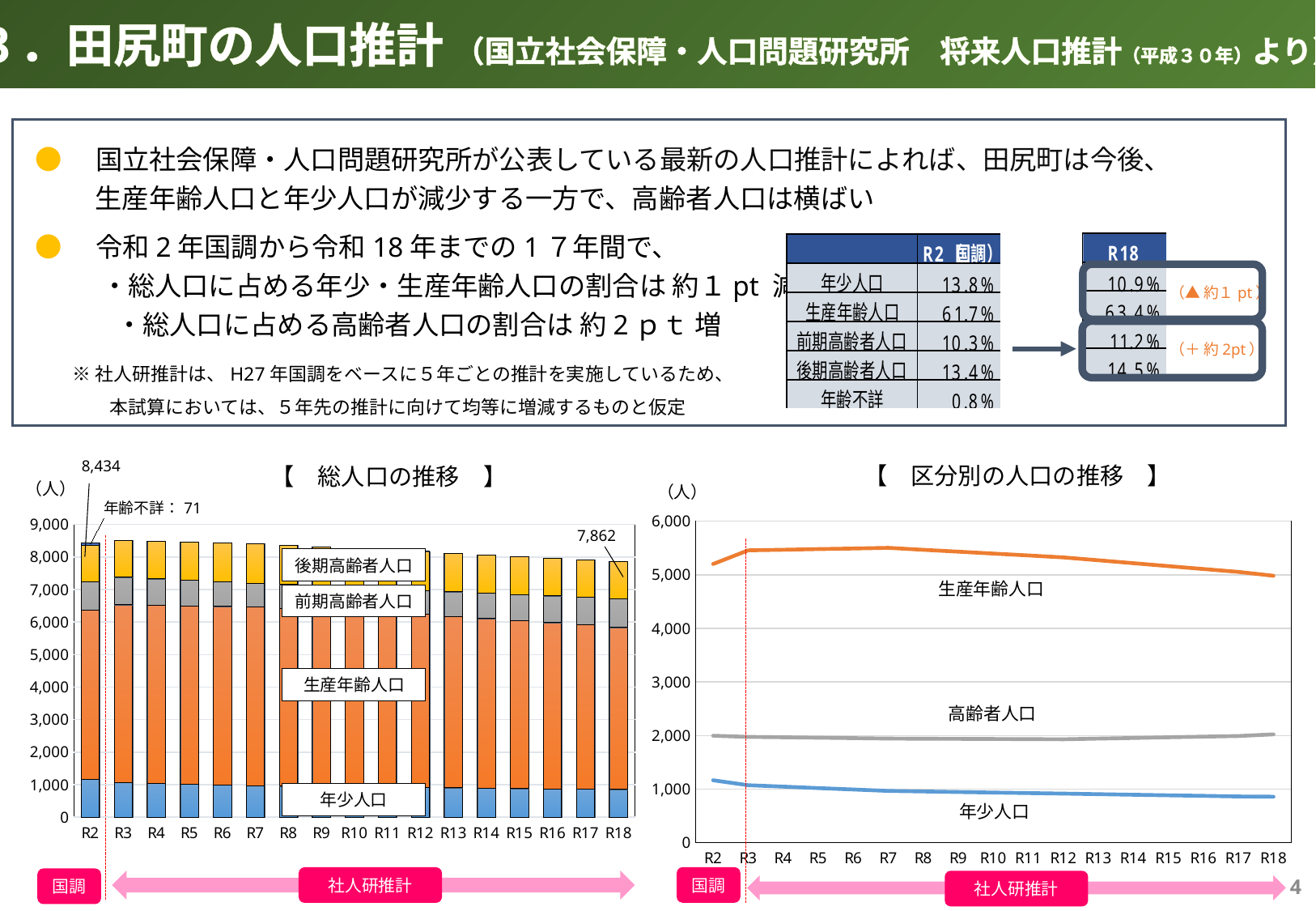
In the 区分別の人口の推移 chart, which population group has the lowest line? 年少人口 In the 区分別の人口の推移 chart, which population group has the highest line? 生産年齢人口 In the 総人口の推移 chart, how many years (bars) are shown on the x axis? 17 In the 総人口の推移 chart, what is the total population value labelled for R2? 8,434 In the 区分別の人口の推移 chart, is the value of 年少人口 at R18 greater or less than 1,000? less In the 総人口の推移 chart, which is larger, the total for R2 or the total for R18? R2 In the 総人口の推移 chart, what is the difference between the labelled totals for R2 and R18? 572 In the 区分別の人口の推移 chart, does the 年少人口 line rise or fall from R2 to R18? fall In the 総人口の推移 chart, what is the total population value labelled for R18? 7,862 What kind of chart is the left chart titled 総人口の推移? bar chart What kind of chart is the right chart titled 区分別の人口の推移? line chart In the 総人口の推移 chart, what value is given for 年齢不詳 in R2? 71